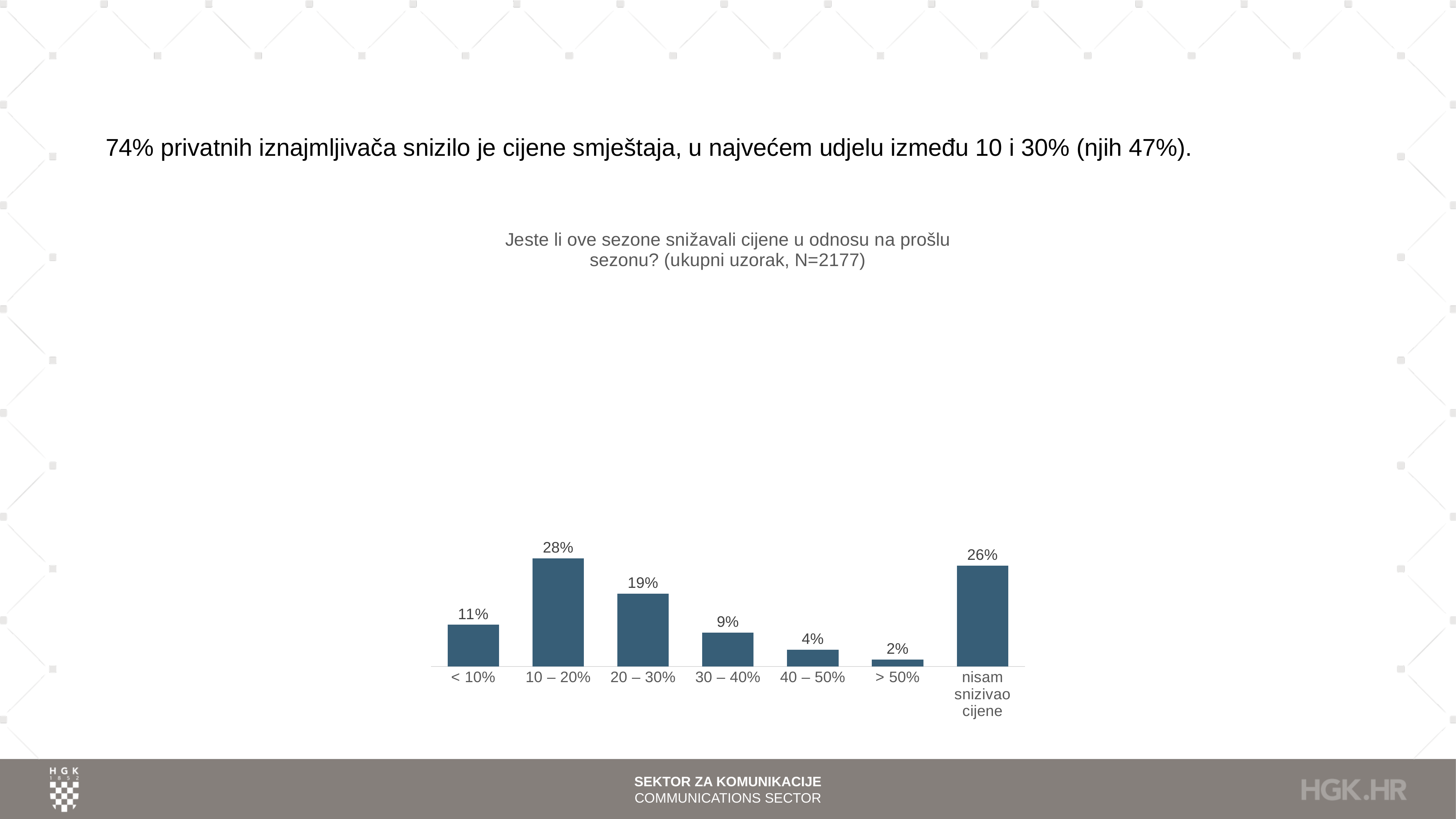
What is the value for the "> 50%" category? 2% Which category has the lowest value? > 50% What is the value for the "10 – 20%" category? 28% What is the difference between the values for "10 – 20%" and "20 – 30%"? 9% How many categories are shown on the x axis? 7 What is the value for the "nisam snizivao cijene" category? 26% Do the values rise or fall from "10 – 20%" to "> 50%"? Fall Which is larger, the value for "30 – 40%" or the value for "40 – 50%"? 30 – 40% What sample size (N) is stated in the chart title? N=2177 What kind of chart is shown on the slide? Bar chart What is the value for the "< 10%" category? 11% Which category has the highest value? 10 – 20%